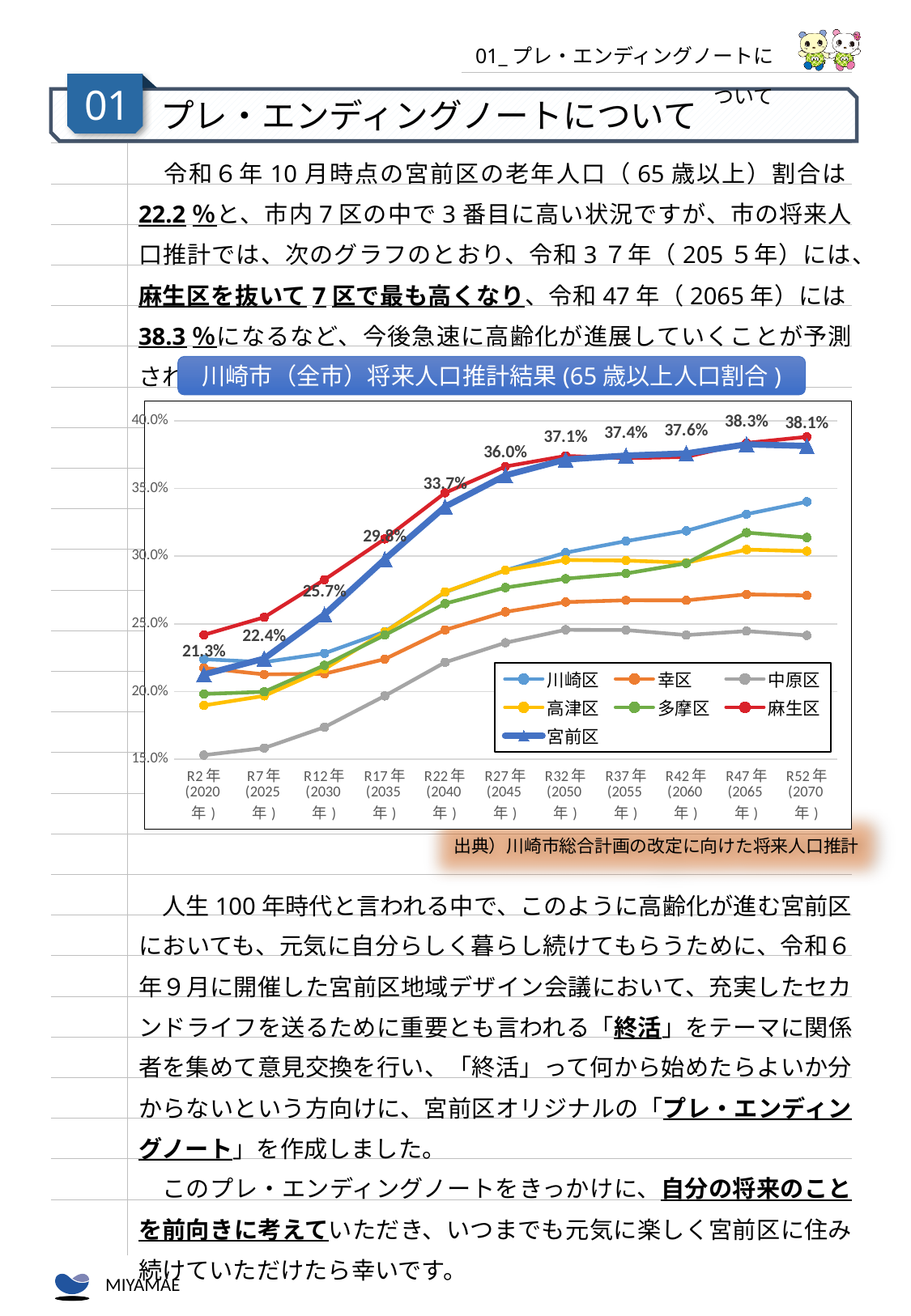
What is the title of the chart? 川崎市（全市）将来人口推計結果(65歳以上人口割合) Does the 宮前区 line rise or fall from R2年(2020年) to R47年(2065年)? rise How many series does the chart legend list? 7 What is the difference between the 宮前区 values at R47年(2065年) and R2年(2020年)? 17.0 percentage points What is the value for 宮前区 at R2年(2020年)? 21.3% What is the value for 宮前区 at R47年(2065年)? 38.3% Is the value for 中原区 at R2年(2020年) greater or less than 20.0%? less At which time point does 宮前区 reach its highest value? R47年(2065年) How many time points are shown along the x axis of the chart? 11 What kind of chart is shown on the slide? line chart What is the value for 宮前区 at R27年(2045年)? 36.0% At R52年(2070年), which is larger: 宮前区 or 川崎区? 宮前区